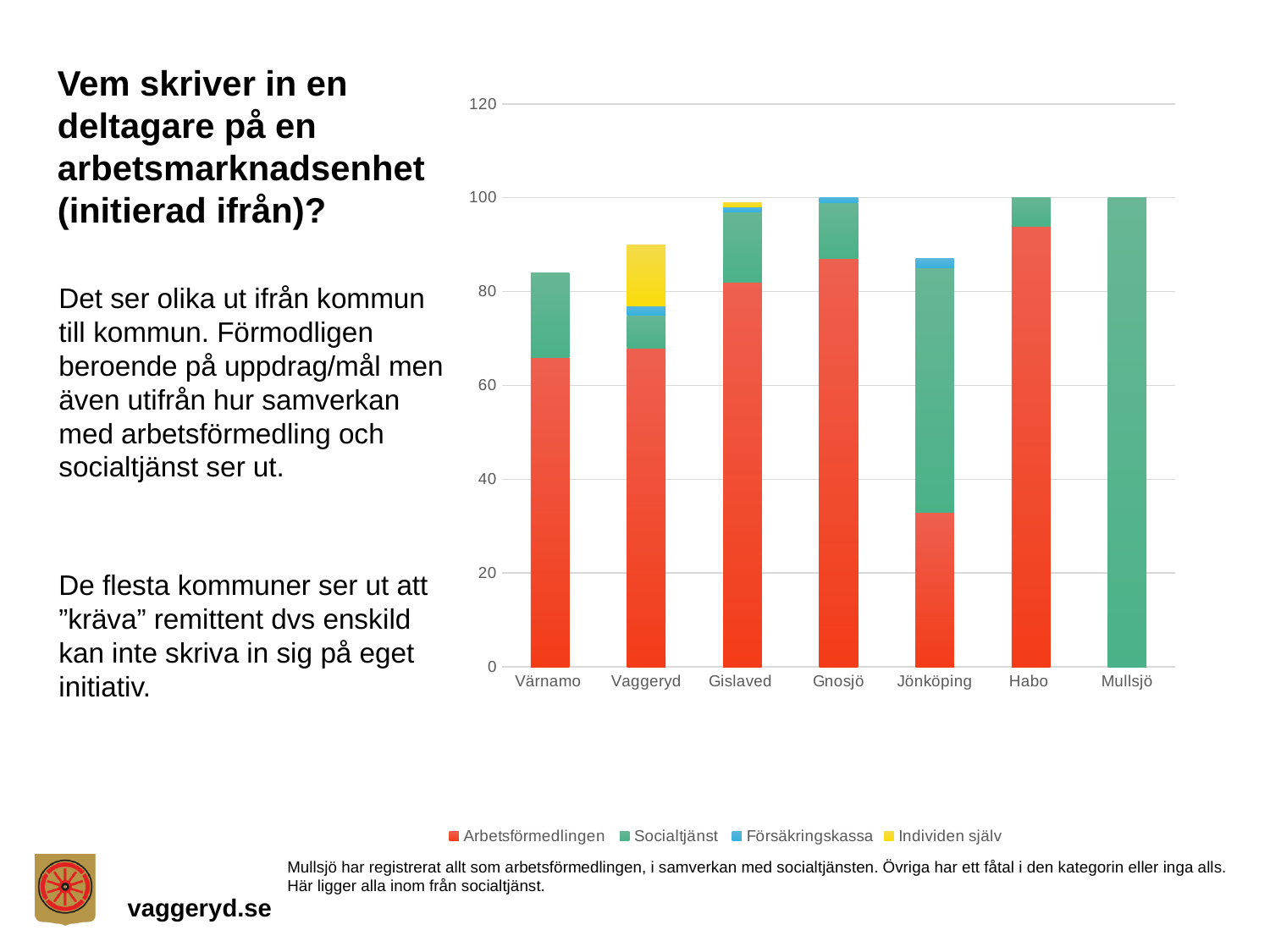
Which has the larger Arbetsförmedlingen value, Värnamo or Jönköping? Värnamo Is the Arbetsförmedlingen value for Jönköping greater or less than 40? less How many municipalities (categories) are shown on the x axis of the chart? 7 Is the Arbetsförmedlingen value for Habo greater or less than 80? greater What kind of chart is shown on the slide? stacked bar chart Is the total value for Värnamo greater or less than 80? greater Which municipality has the largest Socialtjänst segment? Mullsjö How many series does the chart legend list? 4 Which series is shown in yellow in the chart legend? Individen själv What is the total height of the Mullsjö bar? 100